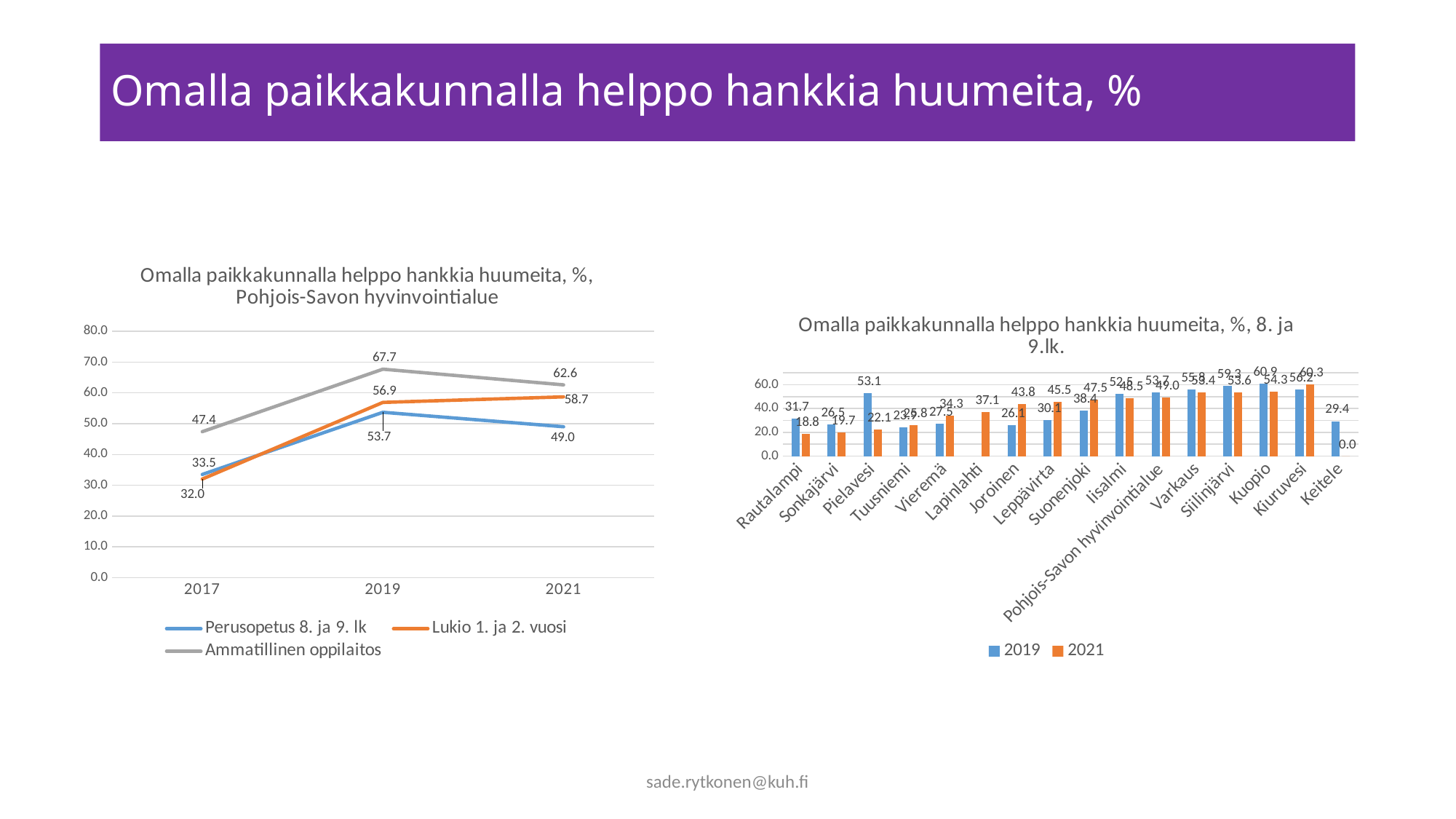
What kind of chart is the chart on the right of the slide? bar chart In the left chart (Pohjois-Savon hyvinvointialue), how many series does the legend list? 3 In the left chart (Pohjois-Savon hyvinvointialue), what is the difference between the Ammatillinen oppilaitos value and the Perusopetus 8. ja 9. lk value in 2021? 13.6 In the right chart (8. ja 9.lk.), how many categories are shown on the x axis? 16 In the right chart (8. ja 9.lk.), which category has the highest 2019 value? Kuopio In the left chart (Pohjois-Savon hyvinvointialue), what is the value for Lukio 1. ja 2. vuosi in 2021? 58.7 What kind of chart is the chart on the left of the slide? line chart In the right chart (8. ja 9.lk.), which is larger for Joroinen, the 2019 value or the 2021 value? 2021 In the right chart (8. ja 9.lk.), what is the 2019 value for Pielavesi? 53.1 In the right chart (8. ja 9.lk.), what is the 2021 value for Lapinlahti? 37.1 In the left chart (Pohjois-Savon hyvinvointialue), what is the value for Ammatillinen oppilaitos in 2019? 67.7 In the left chart (Pohjois-Savon hyvinvointialue), does the Perusopetus 8. ja 9. lk line rise or fall between 2019 and 2021? fall